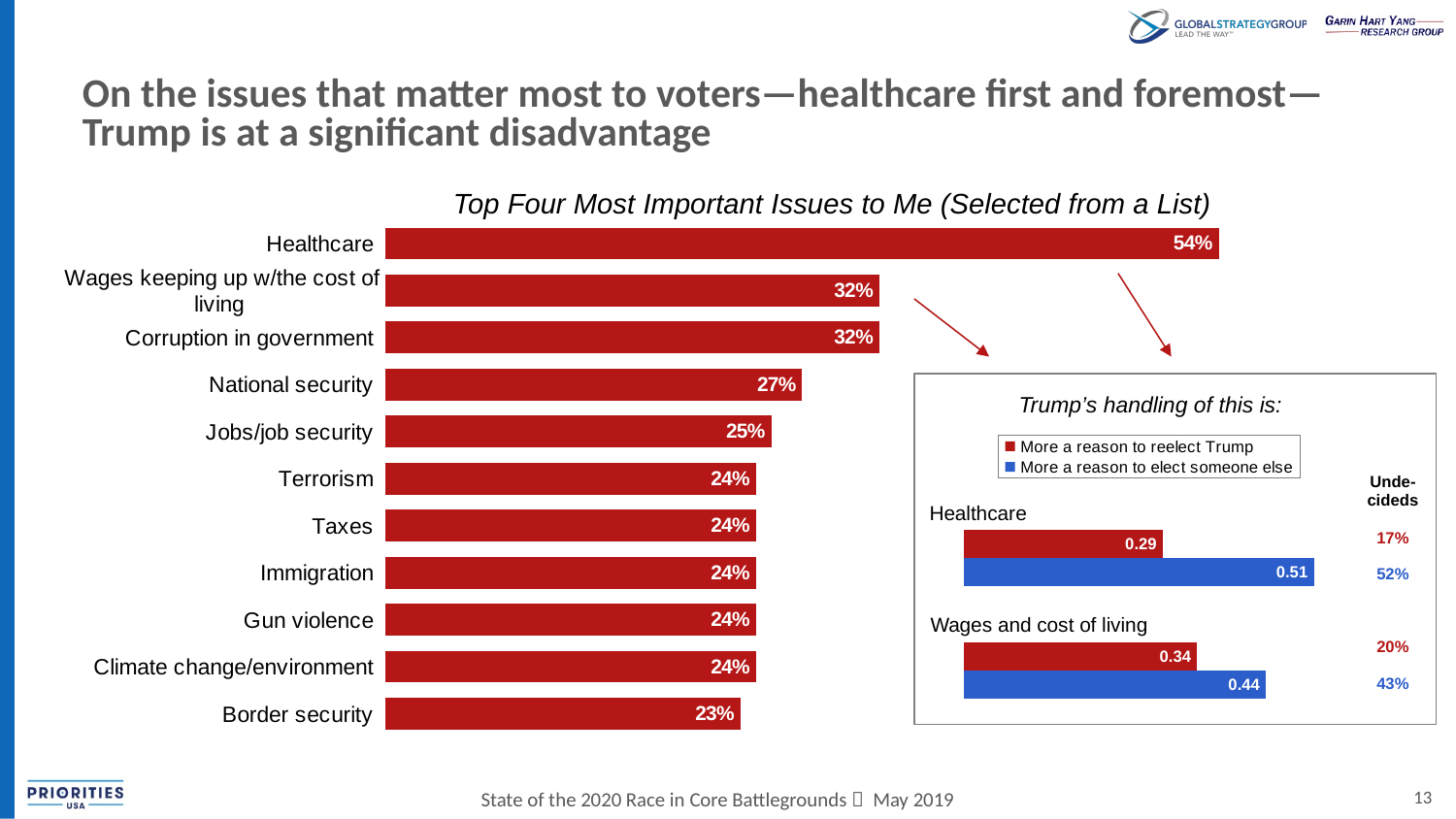
In the 'Trump's handling of this is' chart, which series is shown in blue? More a reason to elect someone else In the 'Trump's handling of this is' chart, what is the value of 'More a reason to elect someone else' for Healthcare? 0.51 In the 'Top Four Most Important Issues to Me' chart, what is the difference between Healthcare and Corruption in government? 22 percentage points In the 'Top Four Most Important Issues to Me' chart, what is the value for National security? 27% In the 'Top Four Most Important Issues to Me' chart, which is larger: Jobs/job security or Terrorism? Jobs/job security How many issues are listed in the 'Top Four Most Important Issues to Me' chart? 11 How many series does the legend of the 'Trump's handling of this is' chart list? 2 In the 'Top Four Most Important Issues to Me' chart, which issue has the highest value? Healthcare In the 'Top Four Most Important Issues to Me' chart, which issue has the lowest value? Border security In the 'Top Four Most Important Issues to Me' chart, what percentage selected Healthcare? 54% In the 'Trump's handling of this is' chart, what is the value of 'More a reason to reelect Trump' for Wages and cost of living? 0.34 What type of chart is the 'Top Four Most Important Issues to Me' chart? Bar chart